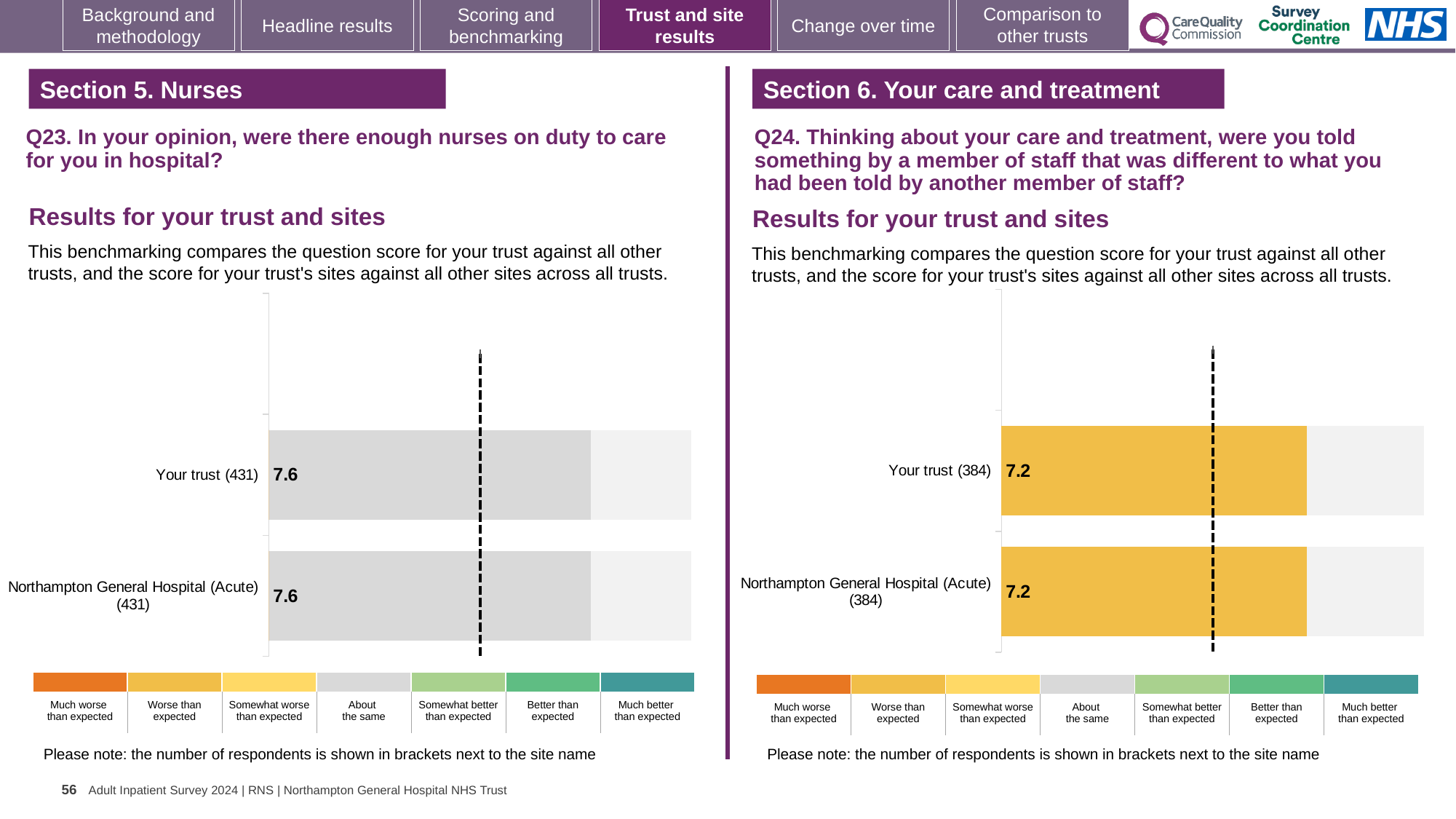
On the Q24 chart (right), what is the difference between the score for Your trust and the score for Northampton General Hospital (Acute)? 0 On the Q23 chart (left), how many respondents are shown in brackets for Your trust? 431 On the Q24 chart (right), which benchmark category does the yellow colour of the bars correspond to in the legend? Worse than expected On the Q24 chart (right), what is the score for Northampton General Hospital (Acute) (384)? 7.2 On the Q24 chart (right), what is the score for Your trust (384)? 7.2 How many bars are plotted on the Q23 chart (left)? 2 On the Q23 chart (left), what is the score for Your trust (431)? 7.6 What type of chart is used on the Q24 chart (right)? Bar chart On the Q23 chart (left), what is the score for Northampton General Hospital (Acute) (431)? 7.6 On the Q23 chart (left), what is the difference between the score for Your trust and the score for Northampton General Hospital (Acute)? 0 On the Q23 chart (left), which benchmark category does the grey colour of the bars correspond to in the legend? About the same How many bars are plotted on the Q24 chart (right)? 2